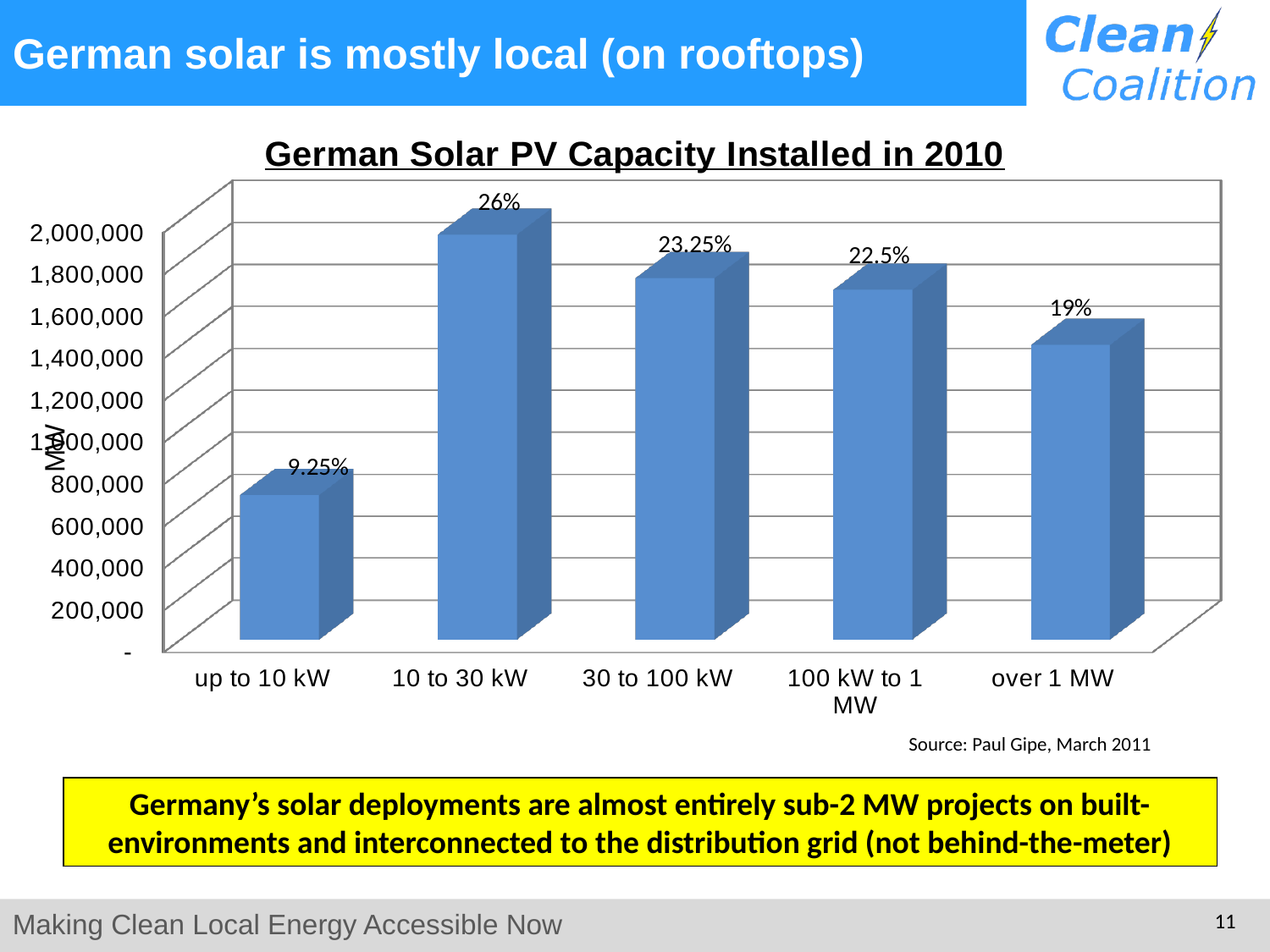
What percentage label is shown on the bar for 10 to 30 kW? 26% How many categories are shown on the x axis? 5 Which has the larger percentage label, 30 to 100 kW or 100 kW to 1 MW? 30 to 100 kW What is the difference in percentage points between the labels for 10 to 30 kW and over 1 MW? 7% Which category has the lowest installed capacity? up to 10 kW Which category has the highest installed capacity? 10 to 30 kW Is the value for up to 10 kW greater or less than 1,000,000 MW? less What percentage label is shown on the bar for over 1 MW? 19% What percentage label is shown on the bar for up to 10 kW? 9.25% What percentage label is shown on the bar for 100 kW to 1 MW? 22.5% What type of chart is shown on the slide? Bar chart Is the value for 10 to 30 kW greater or less than 1,800,000 MW? greater